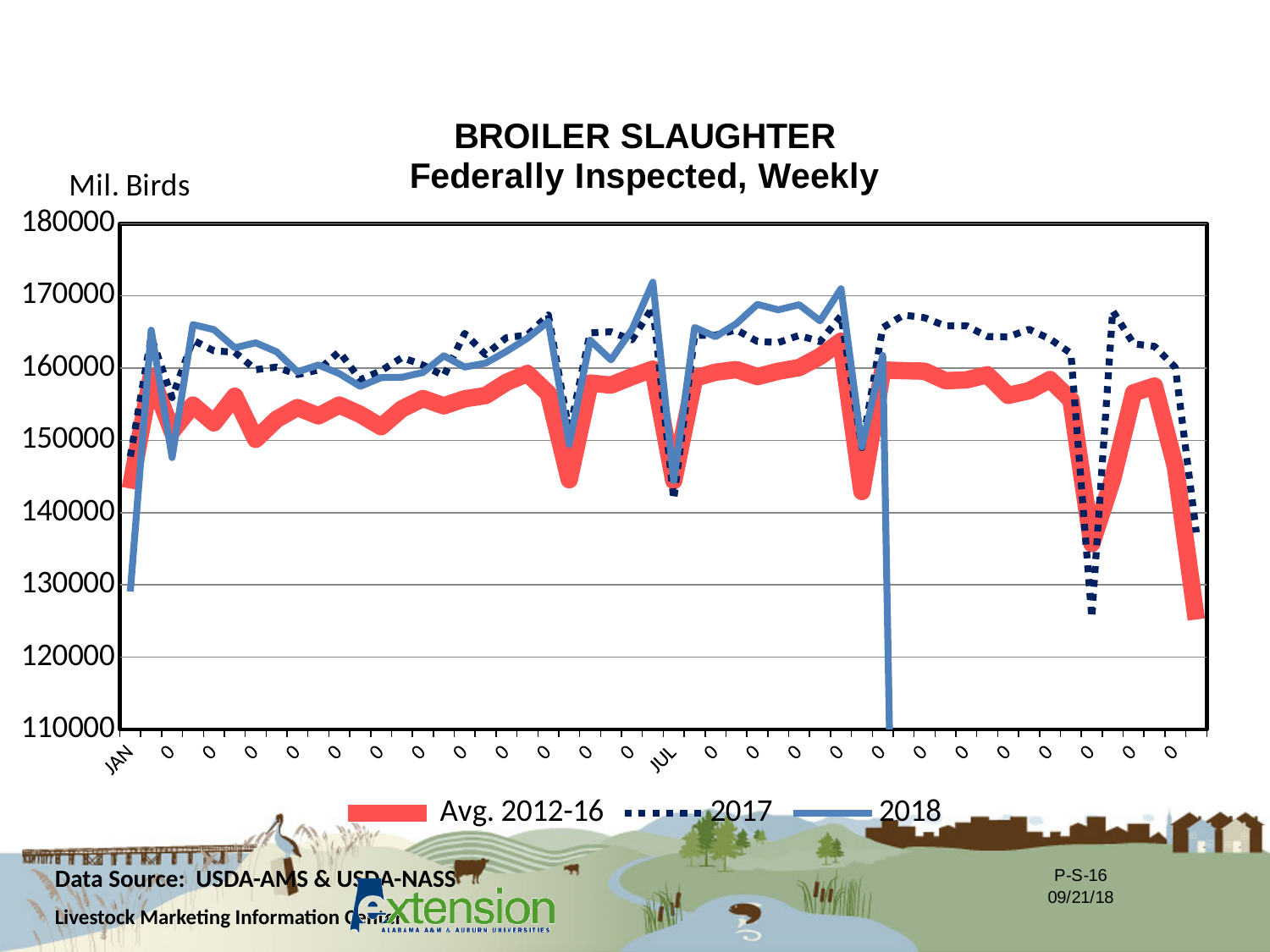
What kind of chart is shown on the slide? line chart What are the three series named in the legend? Avg. 2012-16, 2017, 2018 Is the lowest point of the 2017 line, late in the year, greater or less than 130000? less What is the title of the chart? BROILER SLAUGHTER Federally Inspected, Weekly Is the highest point of the 2018 line greater or less than 160000? greater Is the 2017 value at JUL greater or less than 160000? less Which series runs lowest for most of the year? Avg. 2012-16 At the first week (JAN), which series starts at the lowest value? 2018 How many series does the legend list? 3